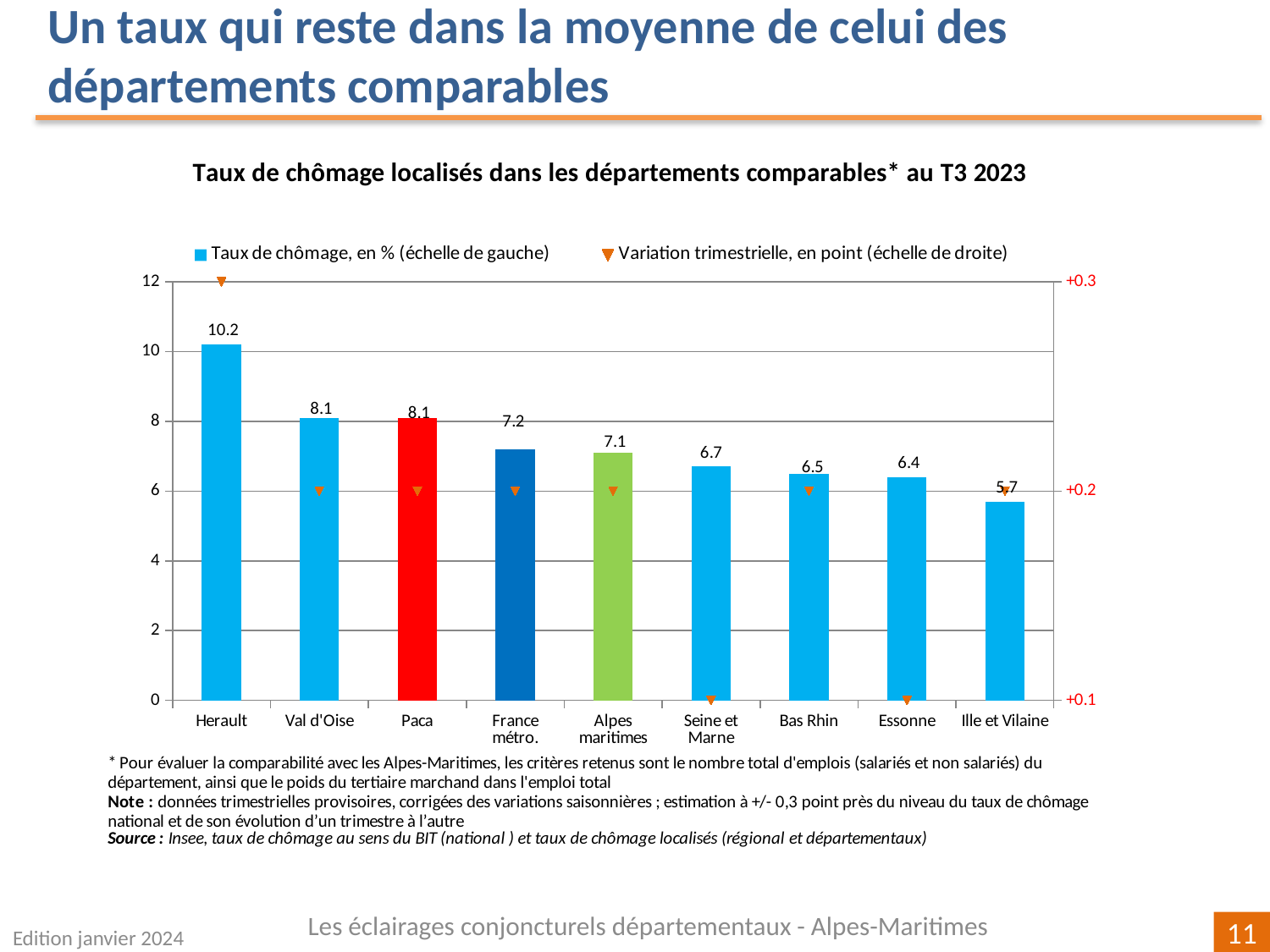
What is the quarterly variation (right axis) shown for Herault? +0.3 What is the unemployment rate shown for Ille et Vilaine? 5.7 What is the unemployment rate shown for Alpes maritimes? 7.1 What kind of chart is used to show the unemployment rates? Bar chart Which department has the lowest unemployment rate on the chart? Ille et Vilaine How many departments or areas are shown on the x axis of the chart? 9 Which department has the highest unemployment rate on the chart? Herault What is the title of the chart? Taux de chômage localisés dans les départements comparables* au T3 2023 How many series does the chart legend list? 2 What is the difference between the unemployment rate of Herault and that of Alpes maritimes? 3.1 Which has a higher unemployment rate, France métro. or Seine et Marne? France métro. What is the unemployment rate shown for Herault? 10.2